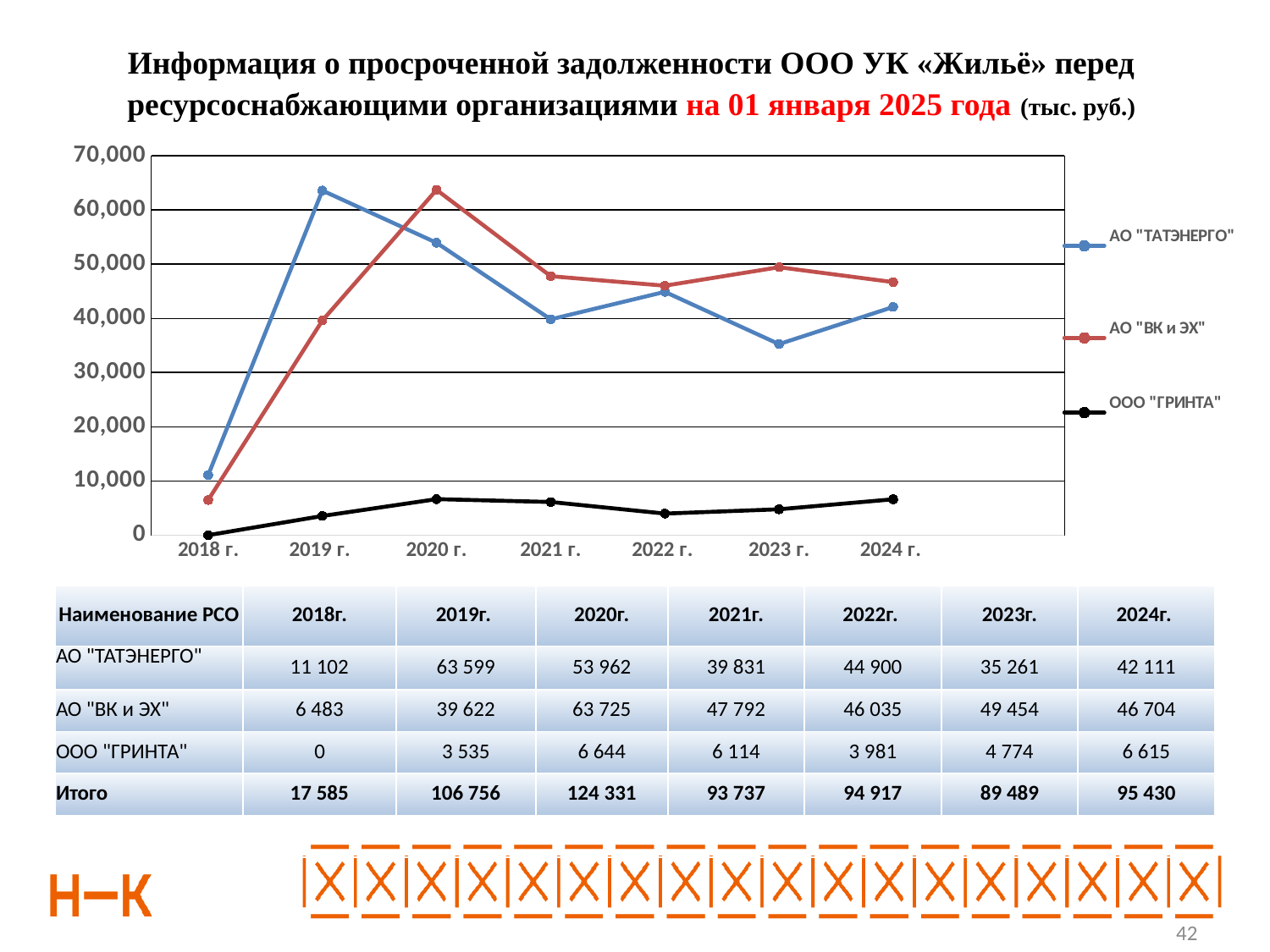
Does the АО "ВК и ЭХ" line rise or fall from 2018 г. to 2020 г.? rise What is the value for АО "ВК и ЭХ" in 2020 г.? 63 725 What kind of chart is shown on the slide? line chart In which year does АО "ТАТЭНЕРГО" reach its highest value? 2019 г. What is the value for ООО "ГРИНТА" in 2024 г.? 6 615 Which series has the larger value in 2023 г., АО "ТАТЭНЕРГО" or АО "ВК и ЭХ"? АО "ВК и ЭХ" What is the difference between АО "ВК и ЭХ" and АО "ТАТЭНЕРГО" in 2024 г.? 4 593 Is the value for АО "ТАТЭНЕРГО" in 2021 г. greater or less than 40,000? less In which year is the value for ООО "ГРИНТА" lowest? 2018 г. How many years are plotted along the x axis of the chart? 7 What is the value for АО "ТАТЭНЕРГО" in 2019 г.? 63 599 How many series does the chart legend list? 3